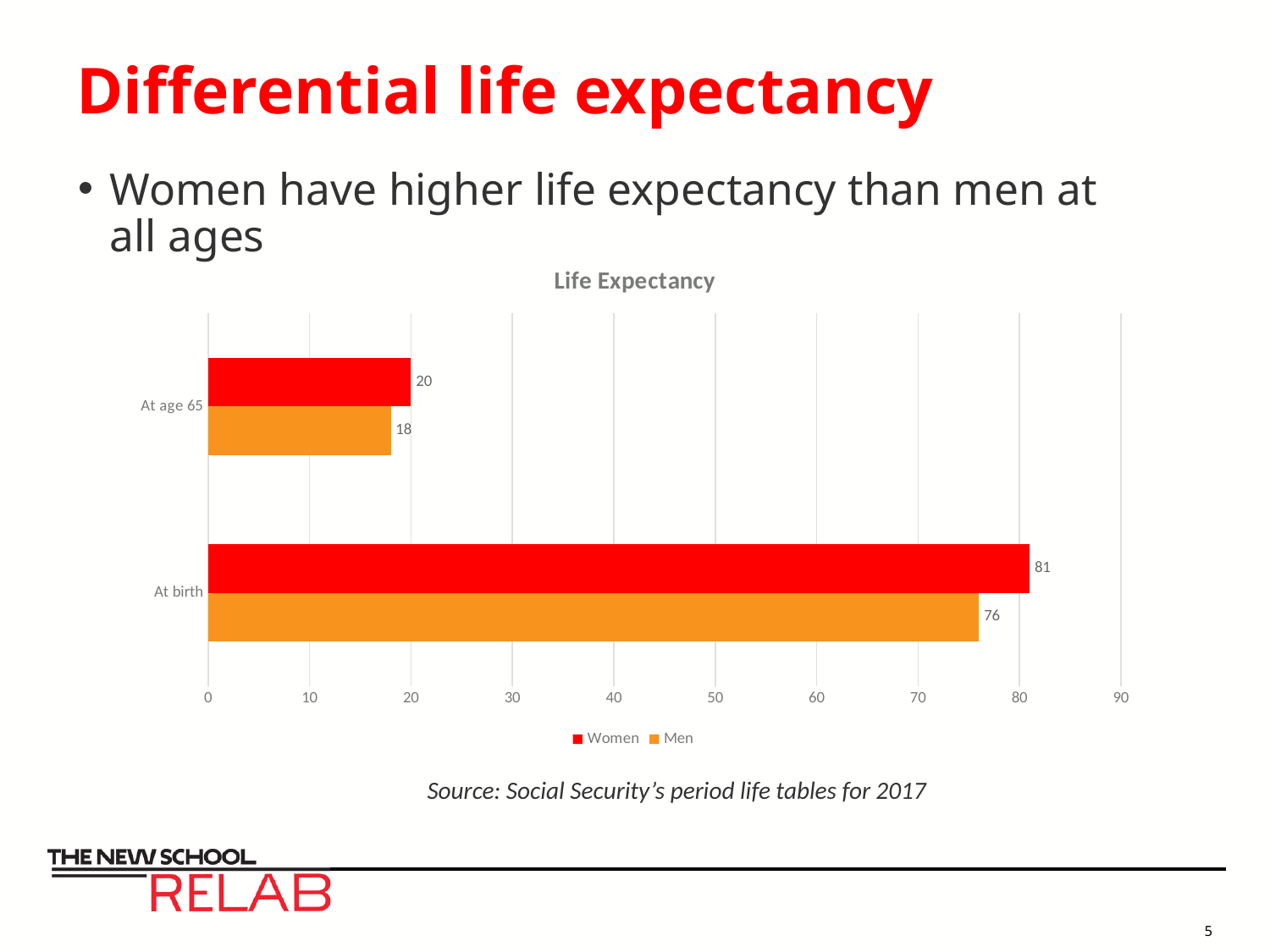
What is the life expectancy for Women at birth? 81 What is the life expectancy for Men at age 65? 18 What is the difference between the Women and Men values at age 65? 2 Which category has the lowest value for Women? At age 65 How many series does the legend list? 2 Which category has the highest value for Men? At birth What is the difference between the Women and Men values at birth? 5 Which series has the larger value at birth, Women or Men? Women How many categories are shown on the chart? 2 What is the life expectancy for Women at age 65? 20 What is the life expectancy for Men at birth? 76 What kind of chart is shown on the slide? Bar chart